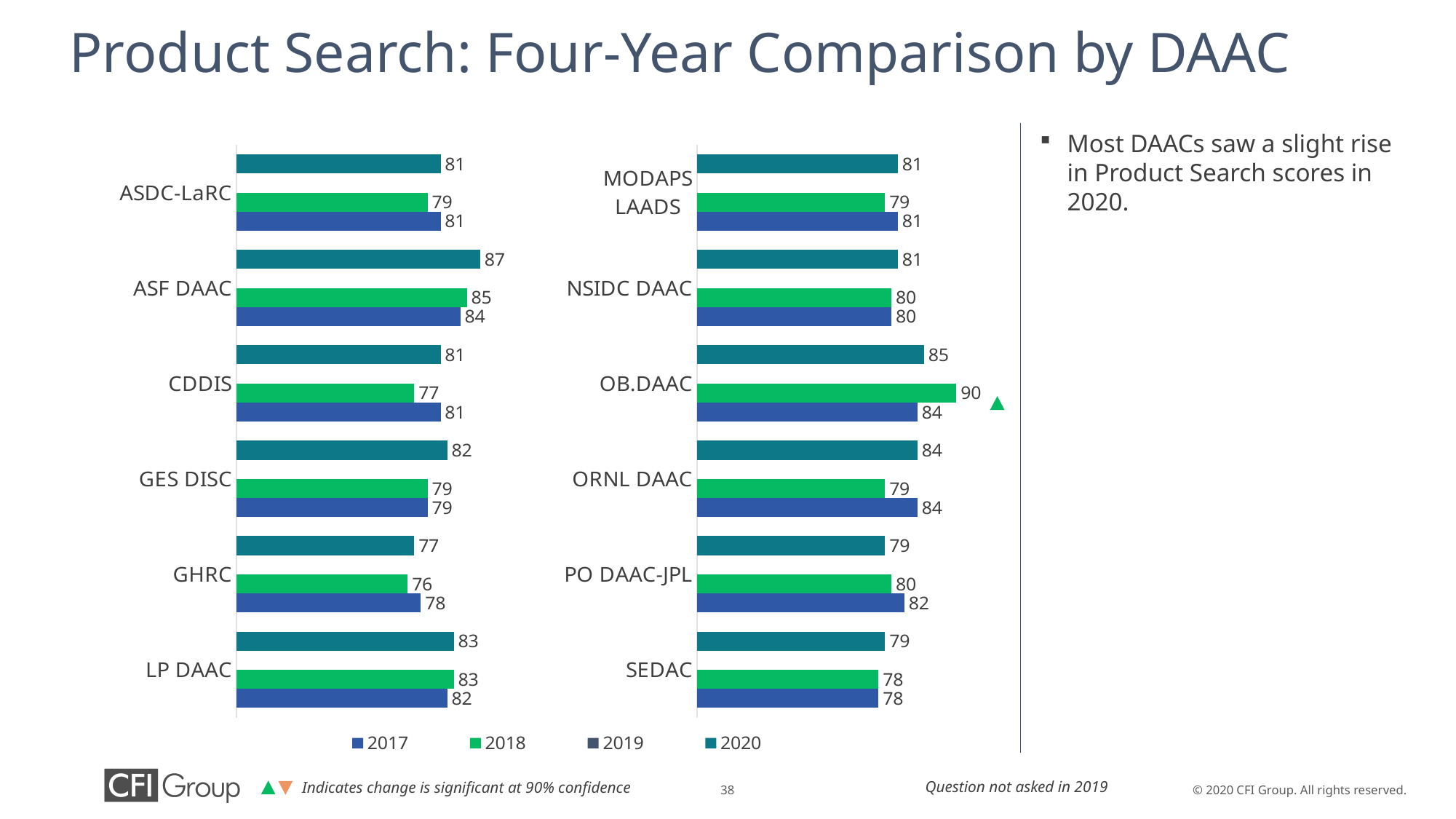
In the right chart, what is the difference between the 2018 and 2020 values for OB.DAAC? 5 In the right chart, which DAAC has the highest 2018 value? OB.DAAC In the left chart, what is the 2020 value for ASF DAAC? 87 What type of chart is used on this slide? Bar chart How many DAACs are shown in the right chart? 6 In the left chart, which DAAC has the highest 2020 value? ASF DAAC In the left chart, is the 2020 value for CDDIS larger than its 2018 value? Yes, 81 vs 77 In the left chart, what is the 2017 value for GHRC? 78 In the right chart, what is the 2020 value for SEDAC? 79 How many series does the legend list? 4 In the left chart, which DAAC has the lowest 2020 value? GHRC In the right chart, what is the 2018 value for OB.DAAC? 90